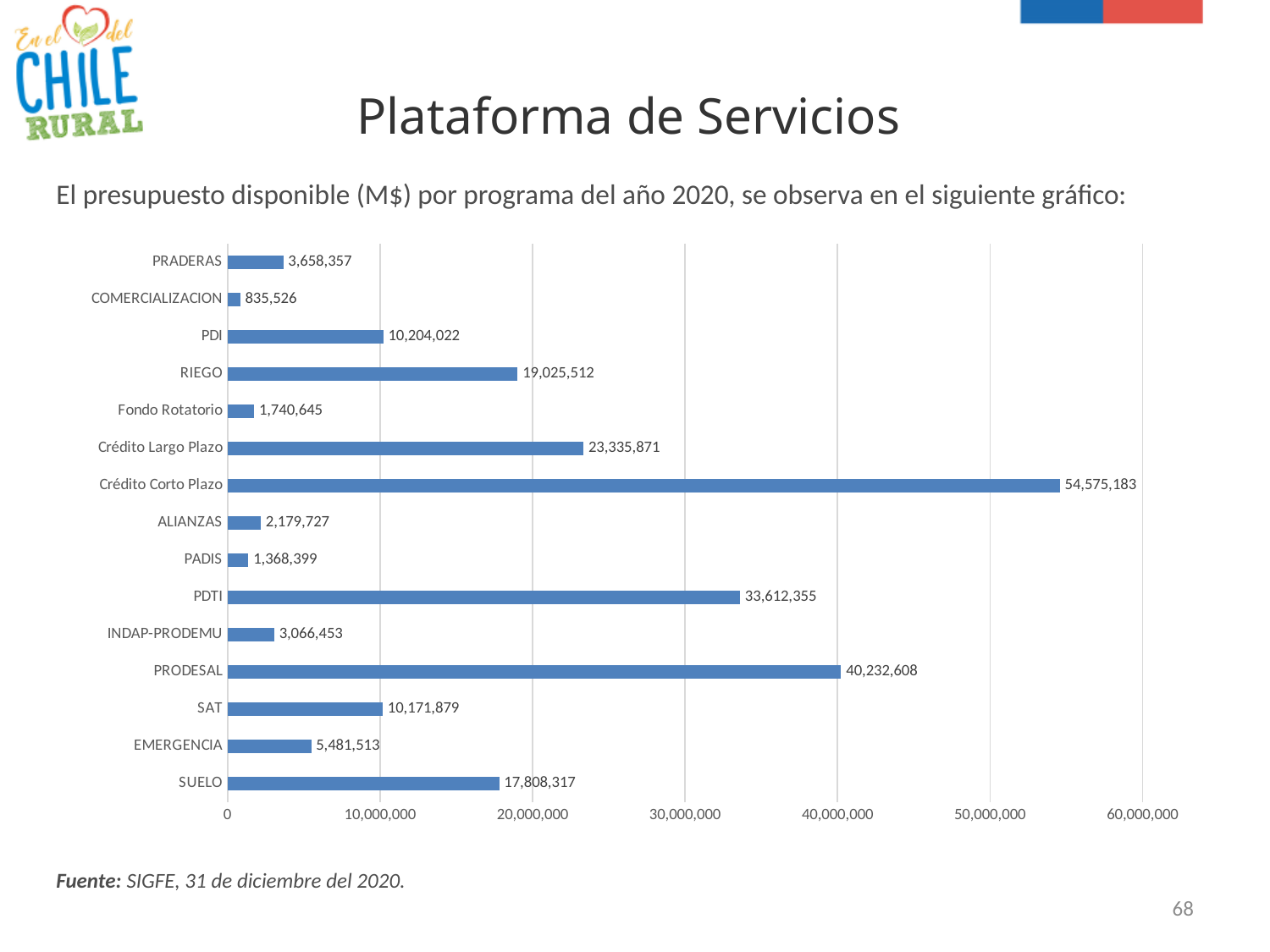
What is the value for Fondo Rotatorio? 1,740,645 Is the value for Crédito Largo Plazo greater or less than 20,000,000? greater How many programs are shown in the chart? 15 What kind of chart is shown on the slide? bar chart What is the value for Crédito Corto Plazo? 54,575,183 What is the value for SUELO? 17,808,317 What is the source cited below the chart? SIGFE, 31 de diciembre del 2020 Which program has the lowest value? COMERCIALIZACION What is the difference between the values for PRODESAL and PDTI? 6,620,253 Which program has the highest value? Crédito Corto Plazo Which is larger, the value for RIEGO or the value for SUELO? RIEGO What is the value for PRODESAL? 40,232,608